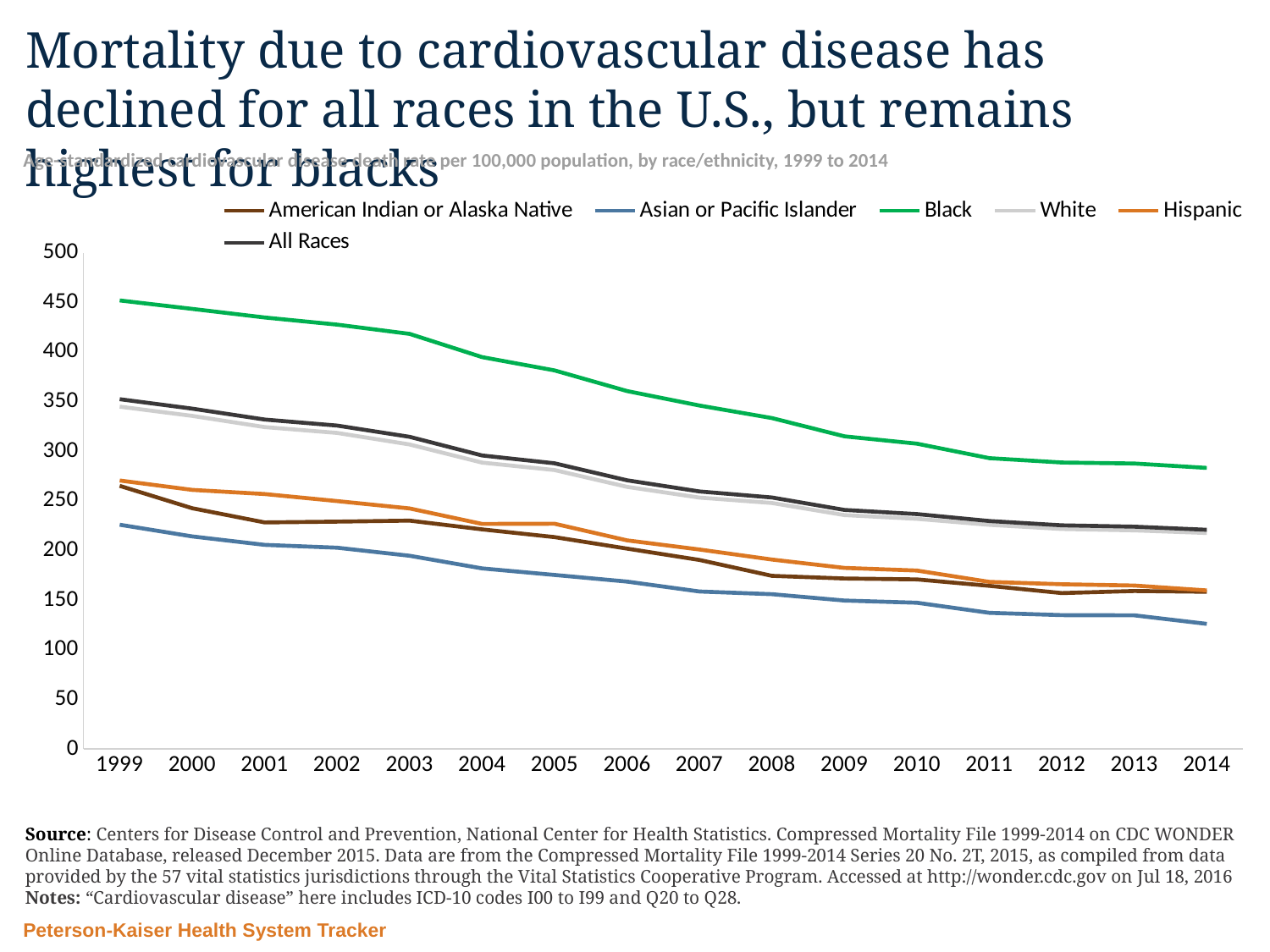
Does the death rate for Black rise or fall from 1999 to 2014? fall How many series does the legend list? 6 What type of chart is shown on the slide? line chart Which race/ethnicity has the highest cardiovascular disease death rate in 2014? Black How many years are shown along the x axis? 16 Is the value for Black in 2014 greater or less than 300? less Is the value for Hispanic in 1999 greater or less than 250? greater In 2005, which is larger: the value for Hispanic or the value for Asian or Pacific Islander? Hispanic What is the first year shown on the x axis? 1999 Which race/ethnicity has the lowest cardiovascular disease death rate in 2014? Asian or Pacific Islander Is the value for Black in 1999 greater or less than 400? greater